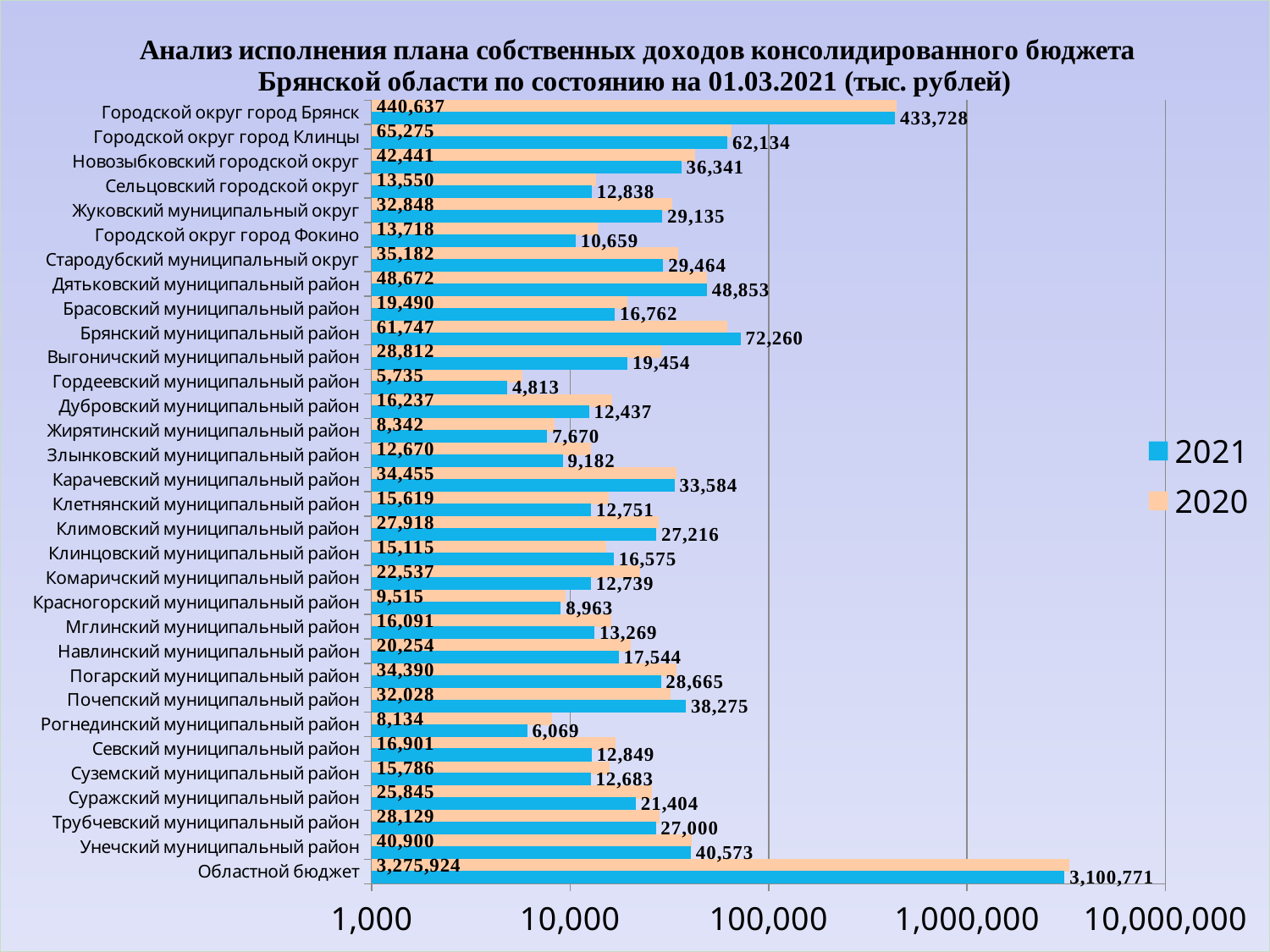
For Почепский муниципальный район, which year has the larger value, 2021 or 2020? 2021 By how much does the 2021 value exceed the 2020 value for Брянский муниципальный район? 10,513 How many series does the legend list? 2 Which category has the highest 2021 value? Областной бюджет What is the 2021 value for Областной бюджет? 3,100,771 How many categories are shown on the chart? 32 What is the difference between the 2020 and 2021 values for Городской округ город Брянск? 6,909 What is the 2020 value for Гордеевский муниципальный район? 5,735 Which category has the lowest 2021 value? Гордеевский муниципальный район What is the 2021 value for Брянский муниципальный район? 72,260 What kind of chart is shown on the slide? Bar chart Is the 2021 value for Областной бюджет greater or less than 1,000,000? greater